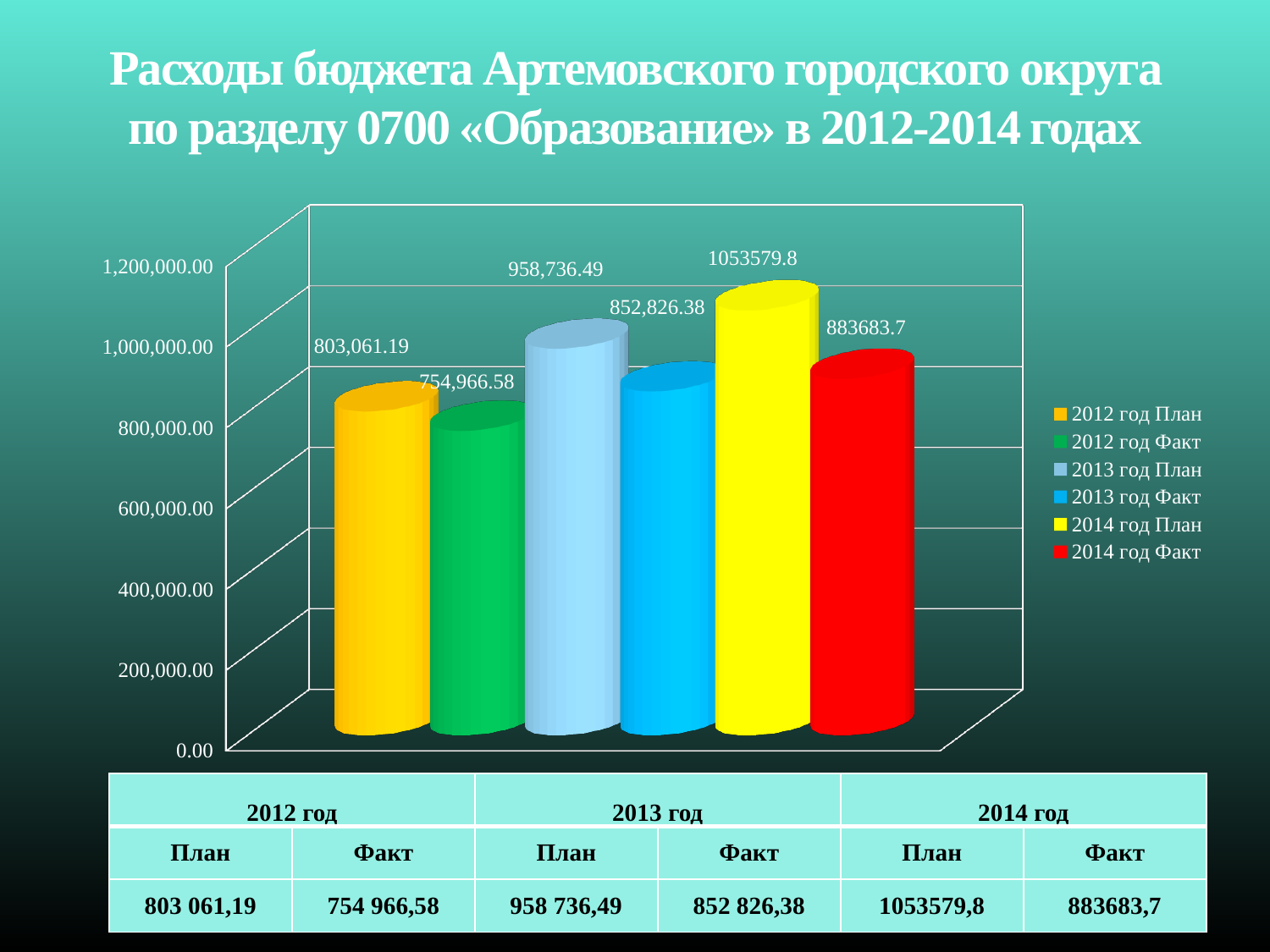
What is the value for 2014 год Факт? 883683.7 Is the value for 2014 год Факт greater or less than 800,000.00? greater Which is larger, 2013 год Факт or 2012 год План? 2013 год Факт Which series has the highest value? 2014 год План What is the value for 2012 год План? 803,061.19 What is the difference between 2013 год План and 2013 год Факт? 105,910.11 What is the difference between 2012 год План and 2012 год Факт? 48,094.61 How many series does the legend list? 6 Which series has the lowest value? 2012 год Факт What kind of chart is shown on the slide? bar chart What is the value for 2013 год Факт? 852,826.38 What is the value for 2014 год План? 1053579.8